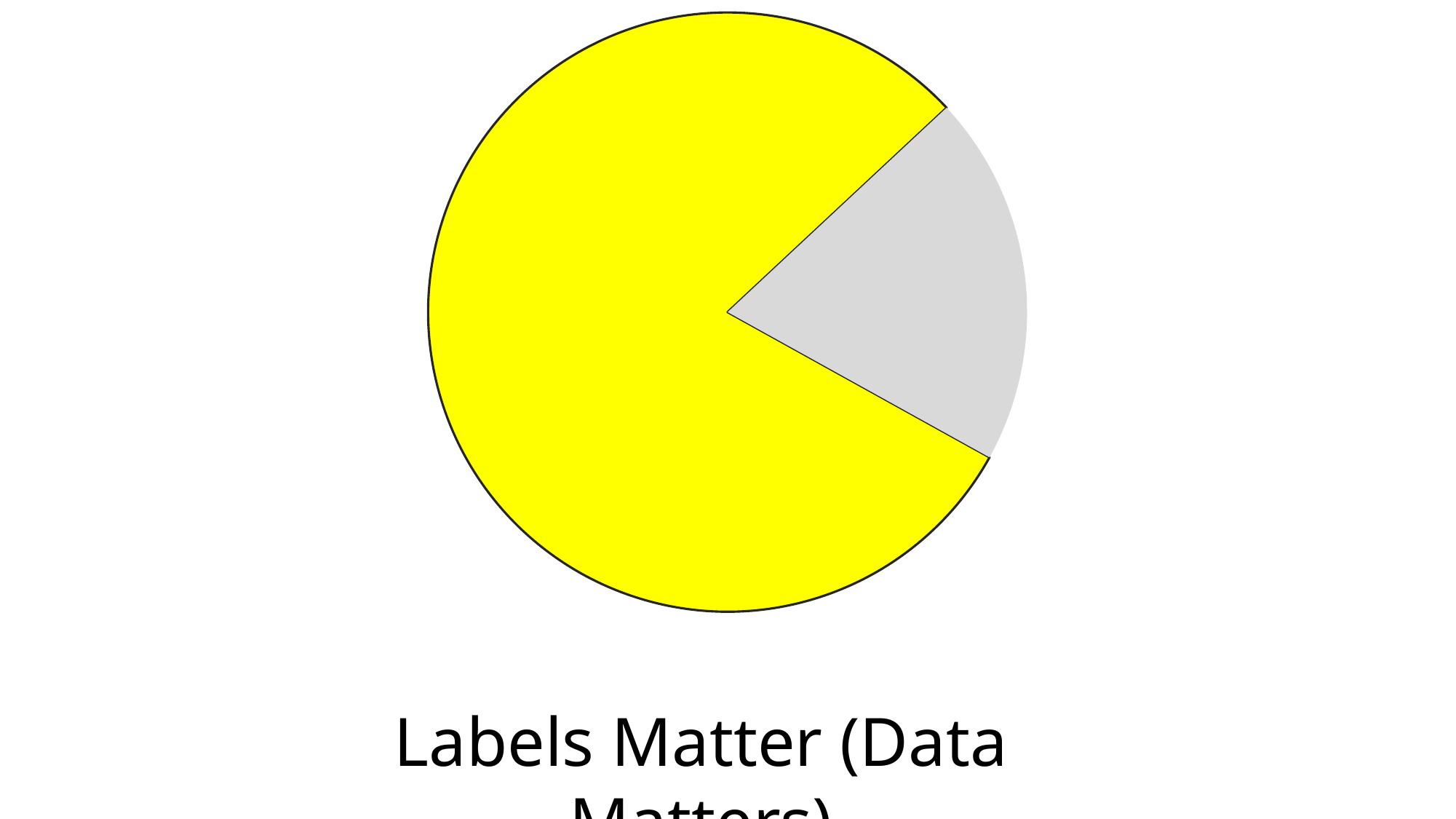
What kind of chart is shown on the slide? pie chart Which slice of the pie chart is the largest? the yellow slice What two colours are used for the slices of the pie chart? yellow and grey Is the yellow slice greater or less than half of the pie? greater Which slice of the pie chart is the smallest? the grey slice How many slices does the pie chart have? 2 Is the grey slice greater or less than half of the pie? less Which slice is larger, the yellow slice or the grey slice? the yellow slice